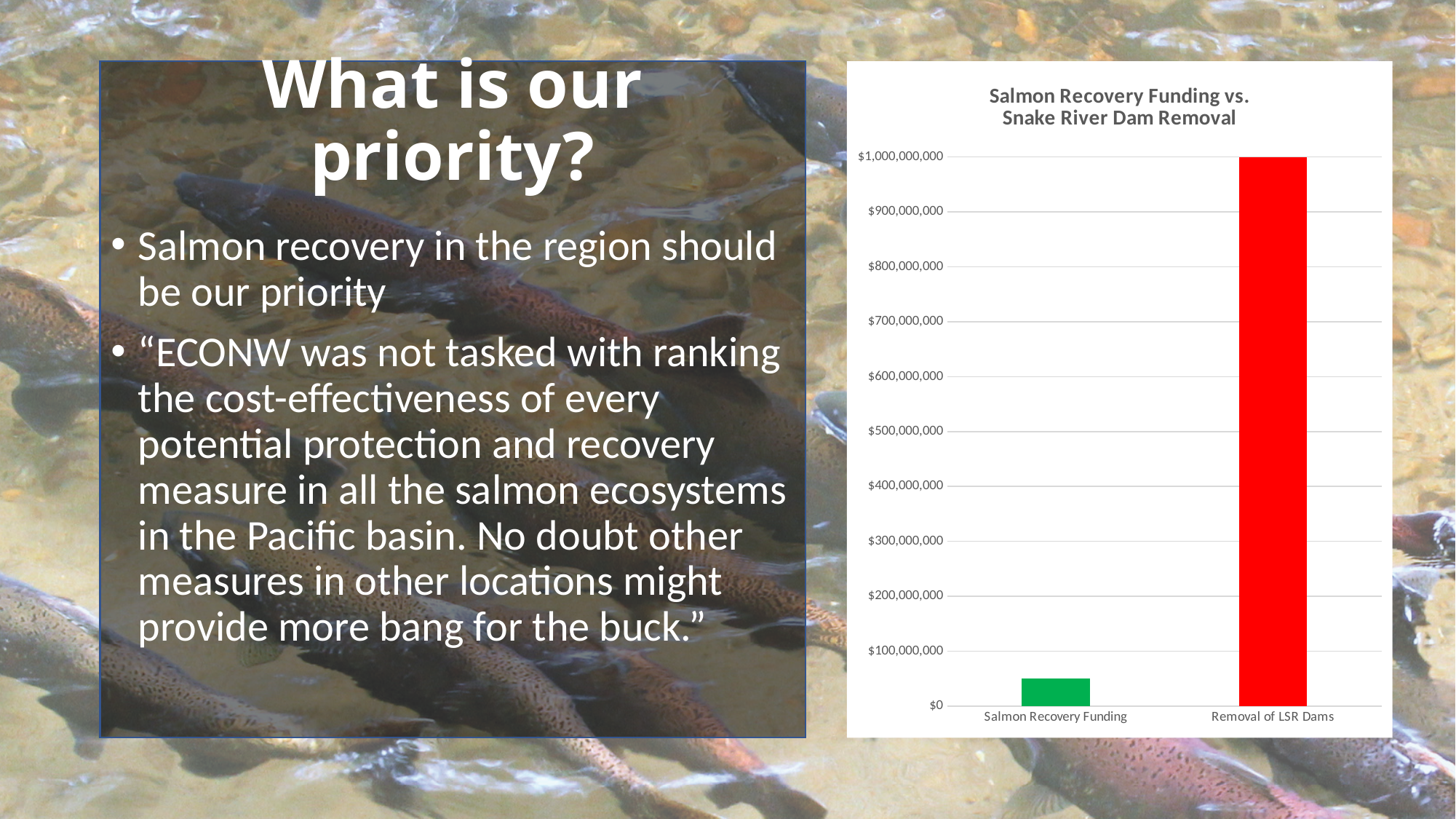
Is the value for Removal of LSR Dams greater or less than $900,000,000? greater Do the values rise or fall from left to right across the categories? rise Is the value for Salmon Recovery Funding greater or less than $100,000,000? less What is the value for Removal of LSR Dams? $1,000,000,000 What kind of chart is shown on the slide? bar chart What colour is the bar for Removal of LSR Dams? red Which category has the highest value in the chart? Removal of LSR Dams What is the title of the chart? Salmon Recovery Funding vs. Snake River Dam Removal Which is larger, the value for Salmon Recovery Funding or the value for Removal of LSR Dams? Removal of LSR Dams Which category has the lowest value in the chart? Salmon Recovery Funding How many categories are plotted in the chart? 2